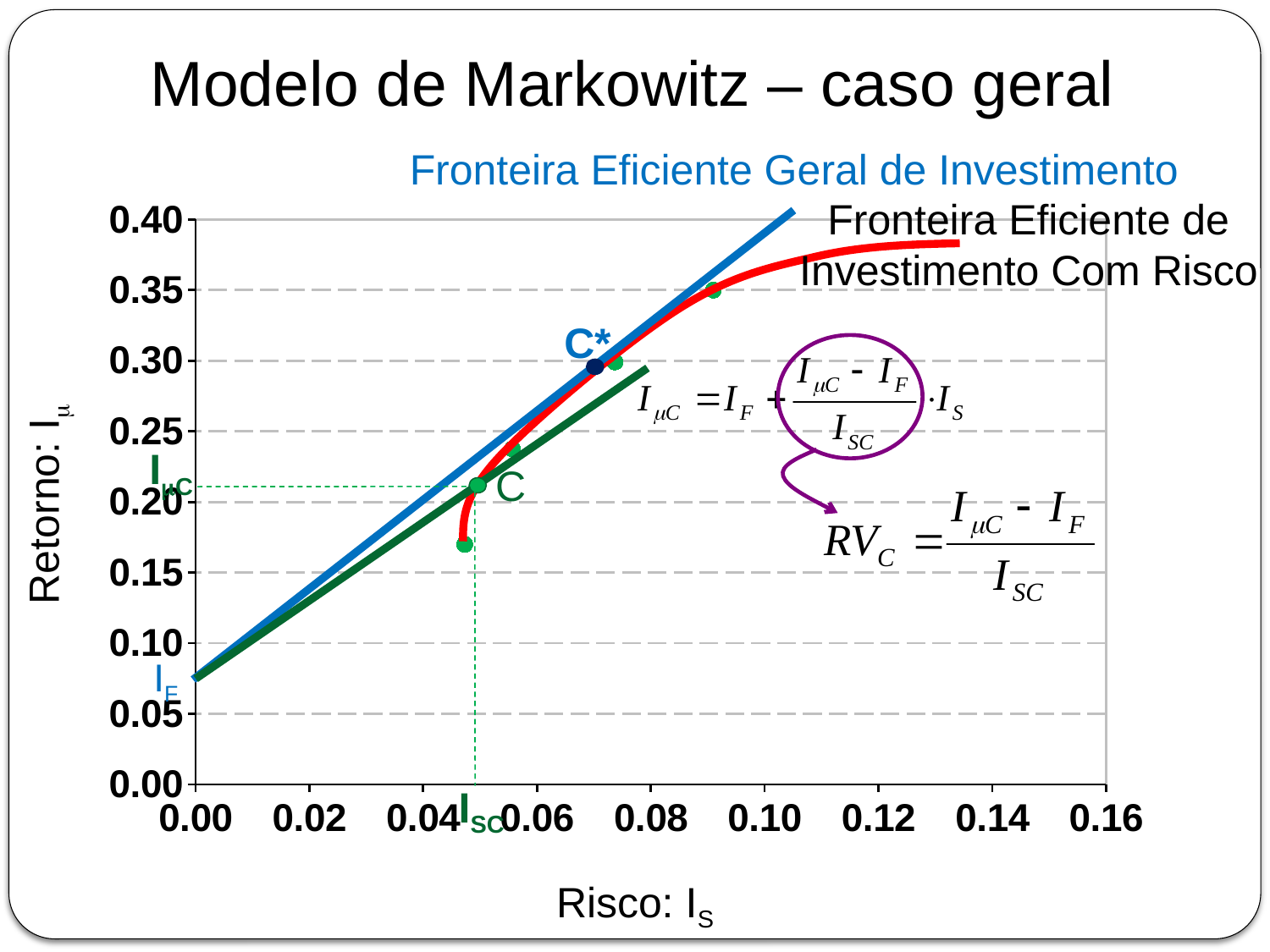
Is the return where the blue line meets the vertical axis (I_F) greater or less than 0.10? less Is the highest return reached by the red curve greater or less than 0.40? less Is the risk (horizontal value) at point C* greater or less than 0.06? greater What kind of chart is shown on the slide? line chart Which point has the higher return, C or C*? C* How many tick labels are shown on the horizontal axis? 9 What is the label of the vertical axis of the chart? Retorno: I_μ What is the label of the horizontal axis of the chart? Risco: I_S Does the blue line rise or fall as risk increases along the x axis? rise